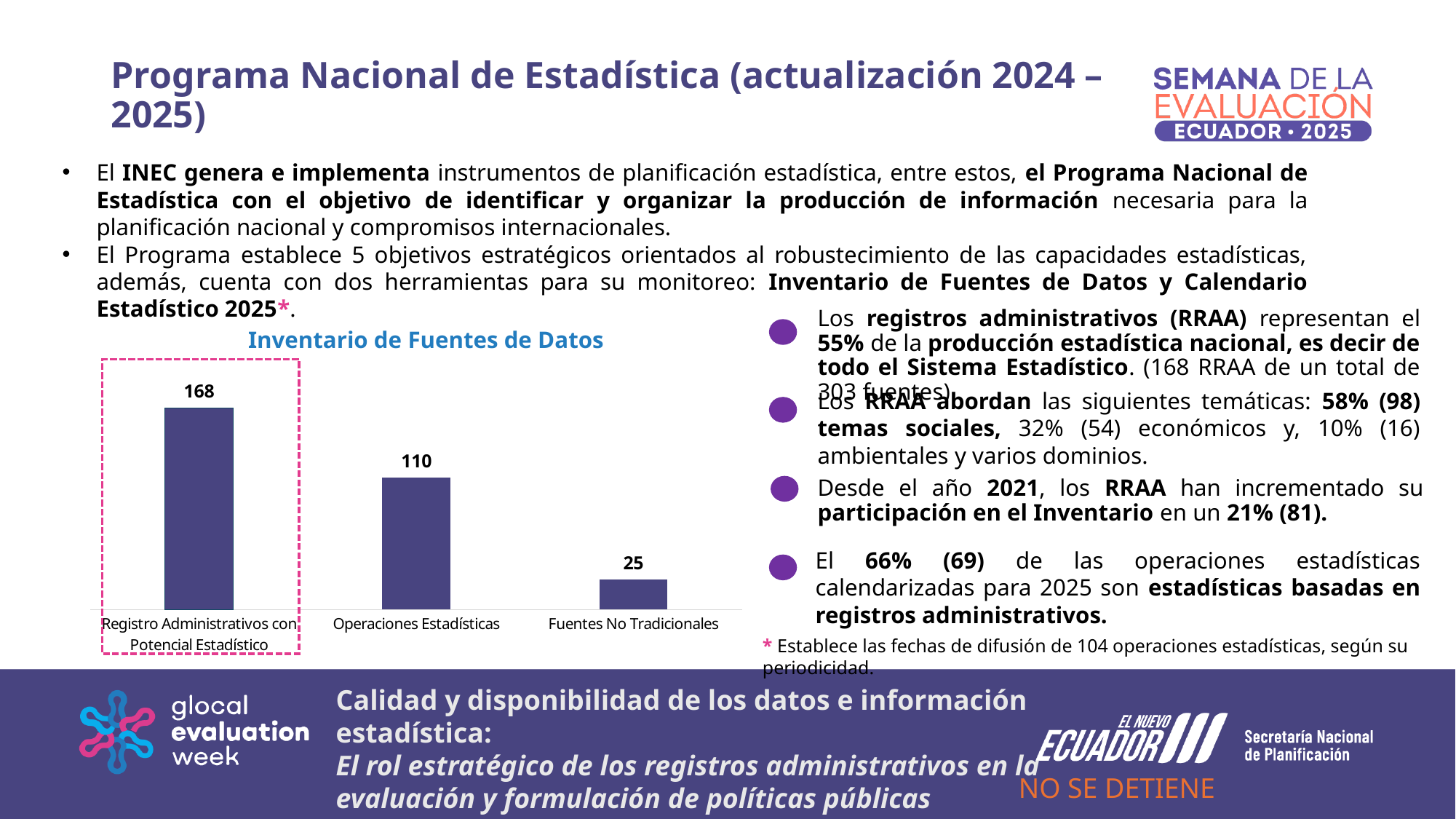
What is the value for Operaciones Estadísticas in the Inventario de Fuentes de Datos chart? 110 Which category has the lowest value in the Inventario de Fuentes de Datos chart? Fuentes No Tradicionales Which category has the highest value in the Inventario de Fuentes de Datos chart? Registro Administrativos con Potencial Estadístico What is the difference between the values for Operaciones Estadísticas and Fuentes No Tradicionales? 85 Which is larger: the value for Operaciones Estadísticas or the value for Fuentes No Tradicionales? Operaciones Estadísticas What kind of chart is the Inventario de Fuentes de Datos chart? Bar chart What is the value for Registro Administrativos con Potencial Estadístico in the Inventario de Fuentes de Datos chart? 168 How many categories are shown in the Inventario de Fuentes de Datos chart? 3 What is the value for Fuentes No Tradicionales in the Inventario de Fuentes de Datos chart? 25 What is the title of the chart on the slide? Inventario de Fuentes de Datos Do the values rise or fall from left to right across the categories in the Inventario de Fuentes de Datos chart? Fall What is the difference between the values for Registro Administrativos con Potencial Estadístico and Operaciones Estadísticas? 58